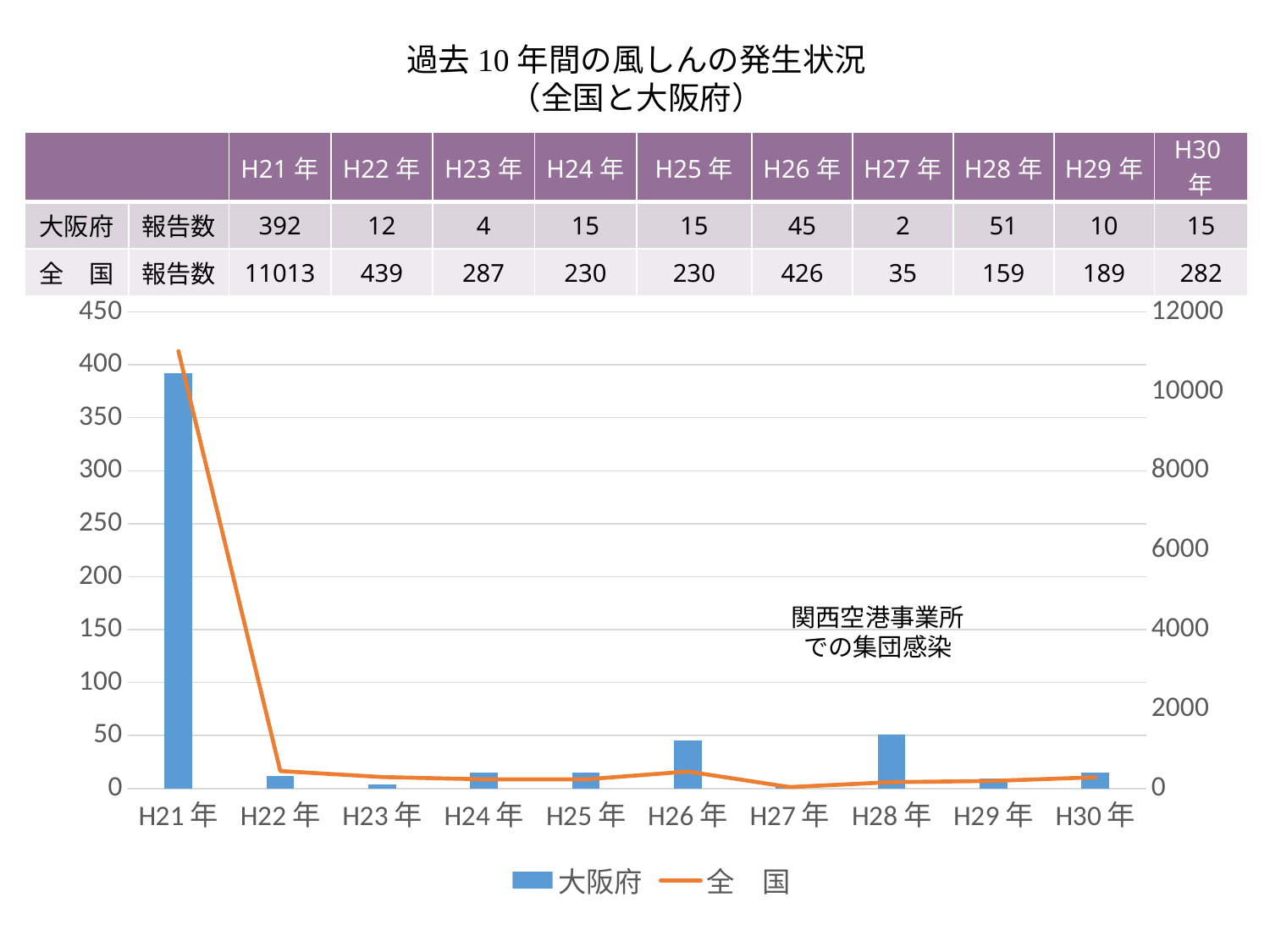
Which year has the lowest 全国 報告数? H27年 Which is larger, the 大阪府 報告数 for H26年 or for H28年? H28年 What is the difference between the 全国 報告数 for H22年 and H23年? 152 Which series is drawn as a line in the chart? 全国 How many series does the legend list? 2 What is the 全国 報告数 for H26年? 426 How many years are shown on the x axis of the chart? 10 What is the maximum value shown on the right-hand y axis? 12000 What is the 大阪府 報告数 for H21年? 392 What is the 大阪府 報告数 for H28年? 51 Does the 全国 報告数 rise or fall from H21年 to H22年? fall Which year has the highest 大阪府 報告数? H21年